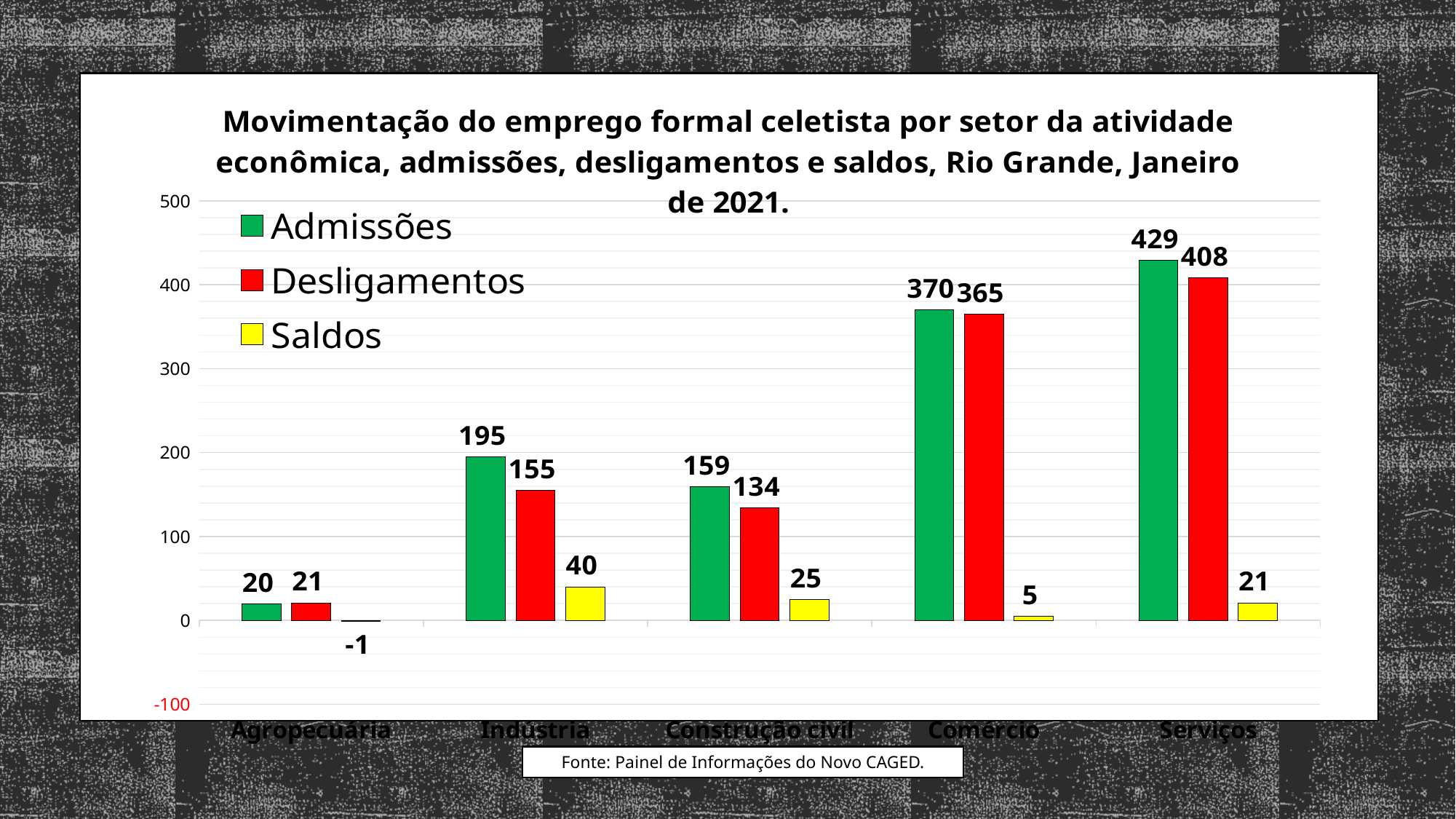
What is the difference between Admissões and Desligamentos for Indústria? 40 What is the Desligamentos value for Construção civil? 134 How many sectors are shown on the x axis? 5 What colour represents the Saldos series? yellow Which sector has the highest Admissões value? Serviços Which is larger for Comércio, Admissões or Desligamentos? Admissões What is the Admissões value for Serviços? 429 Which sector has the lowest Saldos value? Agropecuária How many series does the legend list? 3 Is the Desligamentos value for Serviços greater or less than 400? greater What kind of chart is shown? bar chart What is the Saldos value for Agropecuária? -1